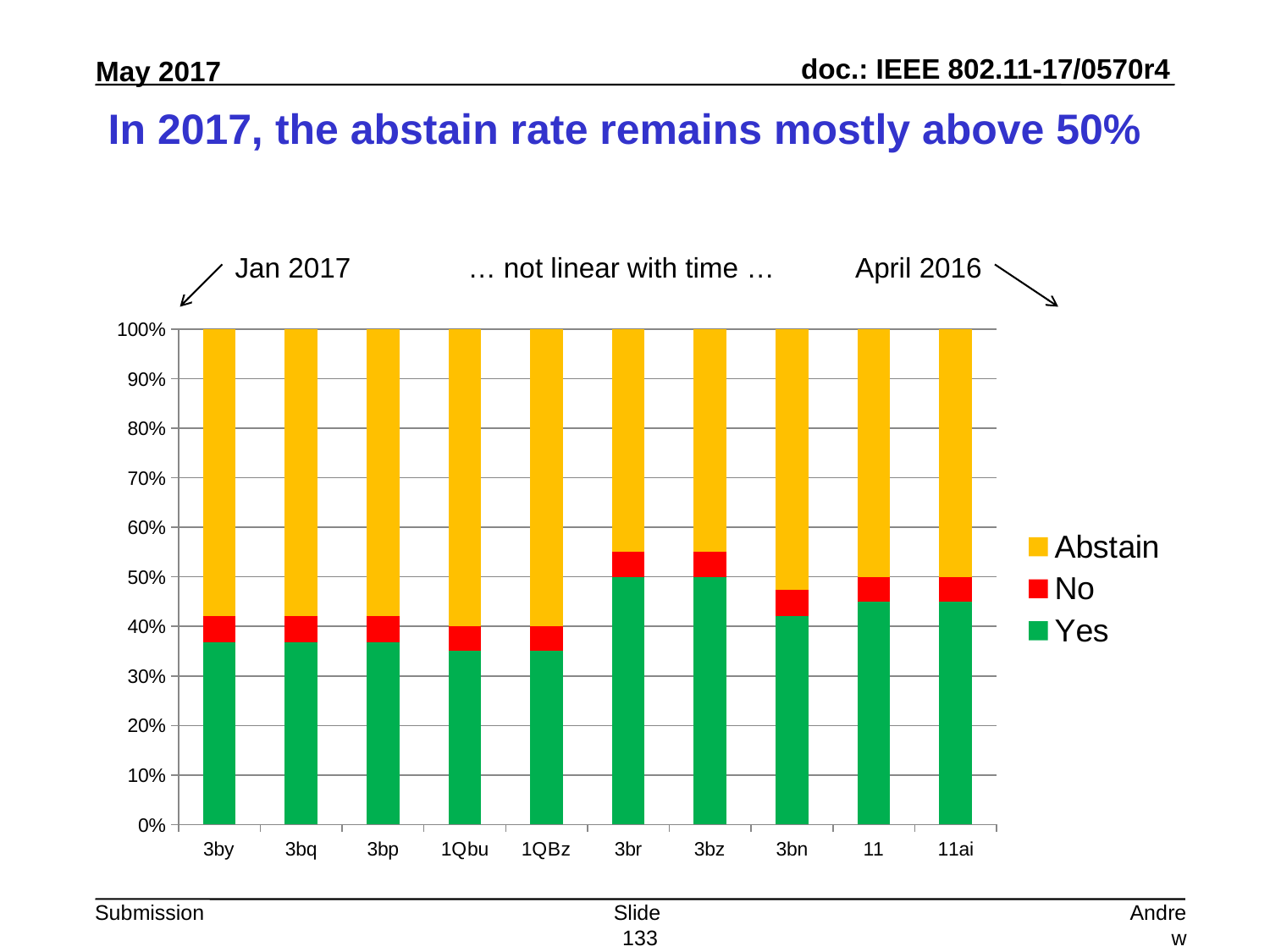
Is the Yes value for 3by greater or less than 40%? less Is the Yes value for 3br greater or less than 40%? greater What is the title of the slide above the chart? In 2017, the abstain rate remains mostly above 50% Which has the larger Abstain share, 3by or 3bz? 3by Is the Abstain share for 3br greater or less than 50%? less Which has the larger Yes value, 3br or 3by? 3br How many categories are shown along the x axis? 10 How many series does the legend list? 3 What are the series listed in the legend? Abstain, No, Yes What kind of chart is shown on the slide? stacked bar chart